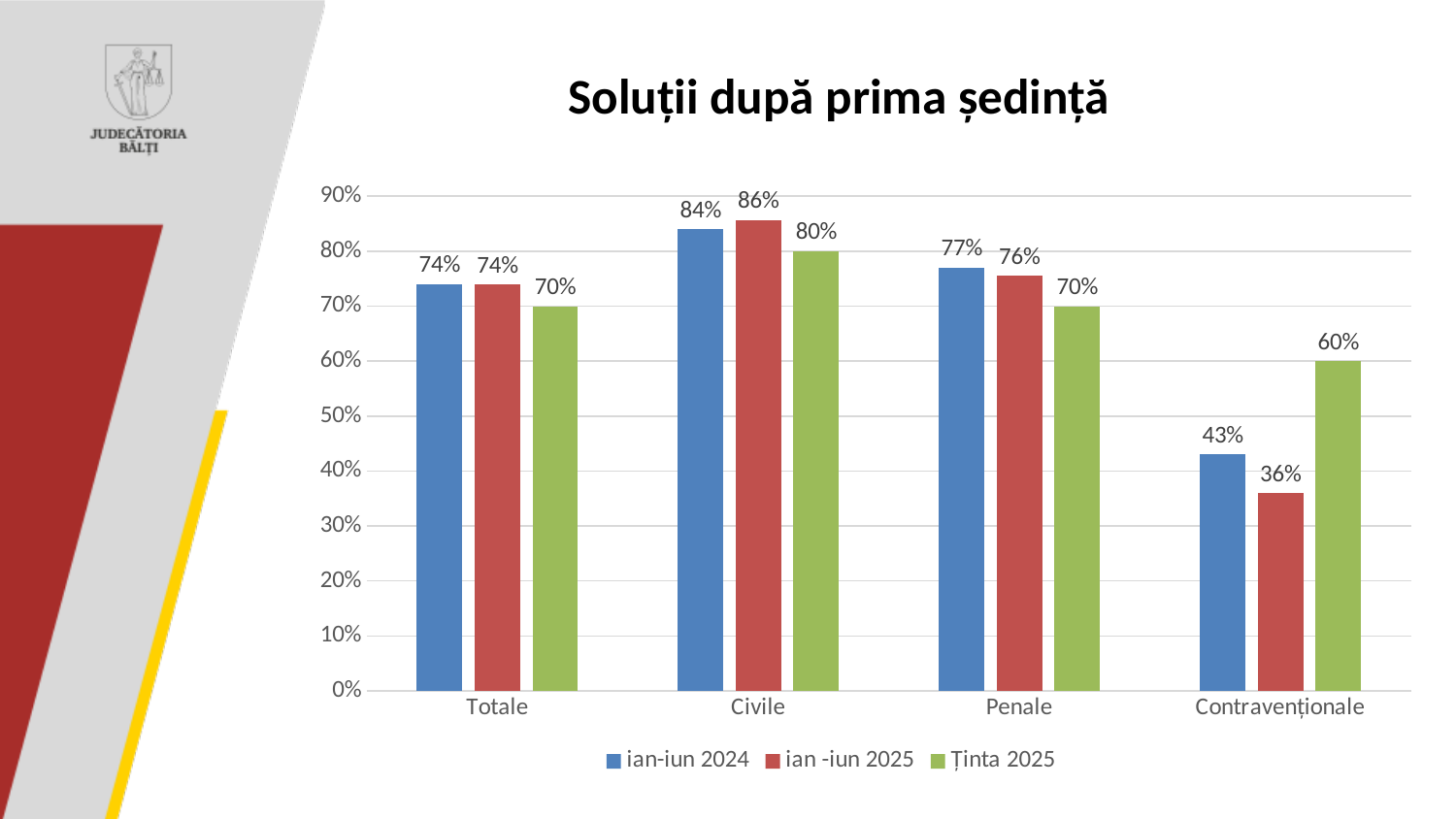
Is the ian -iun 2025 value for Contravenționale greater or less than 40%? less How many categories are shown on the x axis? 4 What is the ian-iun 2024 value for Penale? 77% Which category has the highest ian -iun 2025 value? Civile Which is larger for Penale: the ian-iun 2024 value or the Ținta 2025 value? ian-iun 2024 How many series does the legend list? 3 What is the difference between the ian-iun 2024 and ian -iun 2025 values for Contravenționale? 7% What kind of chart is shown on the slide? Bar chart What is the value for Civile in the ian -iun 2025 series? 86% What is the title of the chart? Soluții după prima ședință Which category has the lowest ian-iun 2024 value? Contravenționale What is the Ținta 2025 value for Contravenționale? 60%